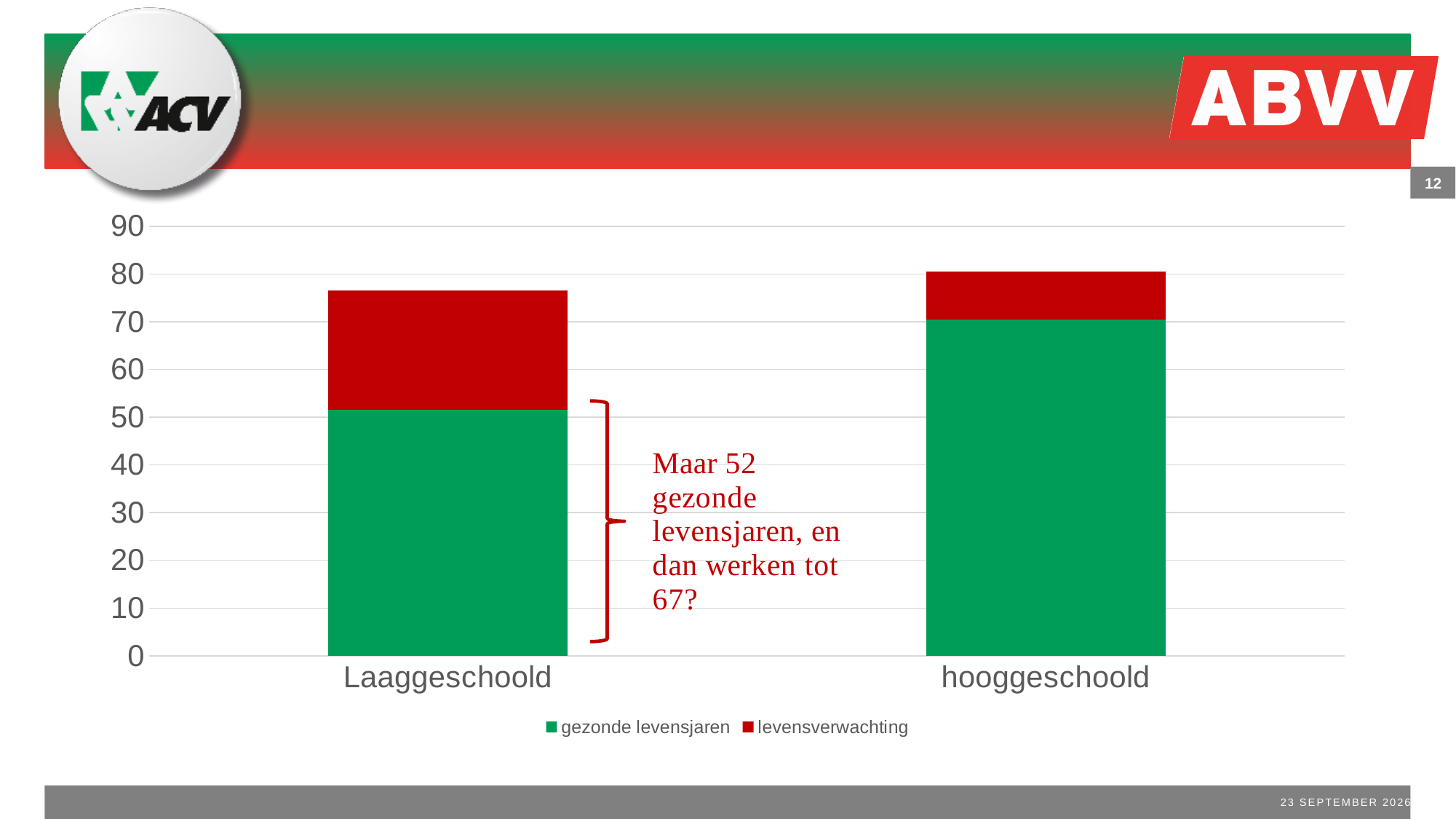
How many series does the chart's legend list? 2 What are the two series named in the chart's legend? gezonde levensjaren and levensverwachting Which category has the larger 'gezonde levensjaren' segment? hooggeschoold Which category has the taller total stacked bar, Laaggeschoold or hooggeschoold? hooggeschoold What kind of chart is shown on the slide? stacked bar chart Which category has the smaller 'gezonde levensjaren' segment? Laaggeschoold Is the total stacked bar for Laaggeschoold greater or less than 80? less How many categories are shown on the x axis of the chart? 2 Is the total stacked bar for hooggeschoold greater or less than 90? less What colour represents the 'levensverwachting' series in the chart? red Is the 'gezonde levensjaren' value for hooggeschoold greater or less than 60? greater